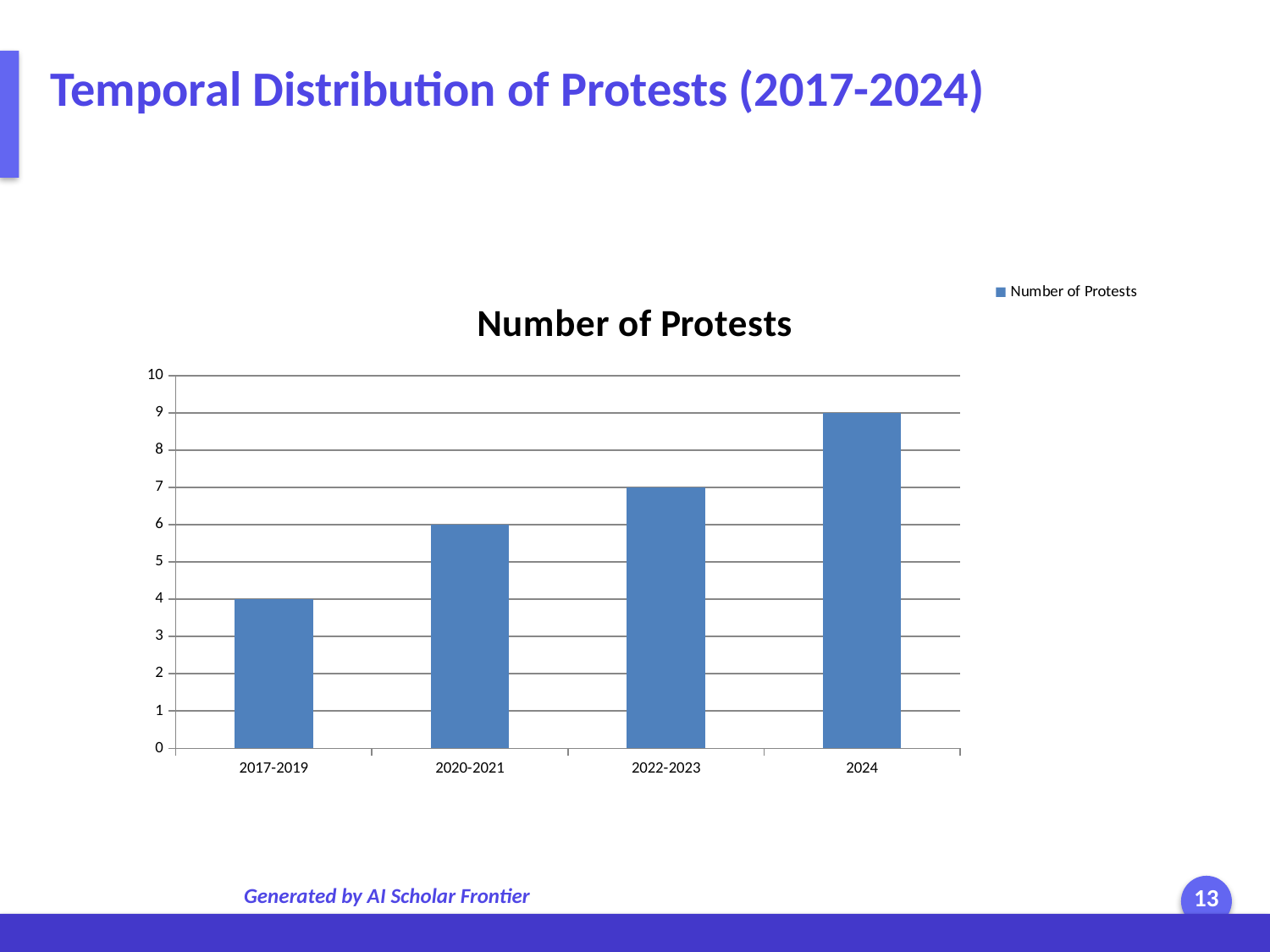
What is the number of protests for 2024? 9 Which period has the highest number of protests? 2024 Is the value for 2024 greater or less than 8? greater What kind of chart is shown on the slide? Bar chart What is the number of protests for 2022-2023? 7 Which period has the lowest number of protests? 2017-2019 What is the number of protests for 2017-2019? 4 What is the difference in the number of protests between 2024 and 2017-2019? 5 Do the values rise or fall from 2017-2019 to 2024? Rise How many periods are shown on the x axis? 4 What is the number of protests for 2020-2021? 6 Which has more protests, 2020-2021 or 2022-2023? 2022-2023